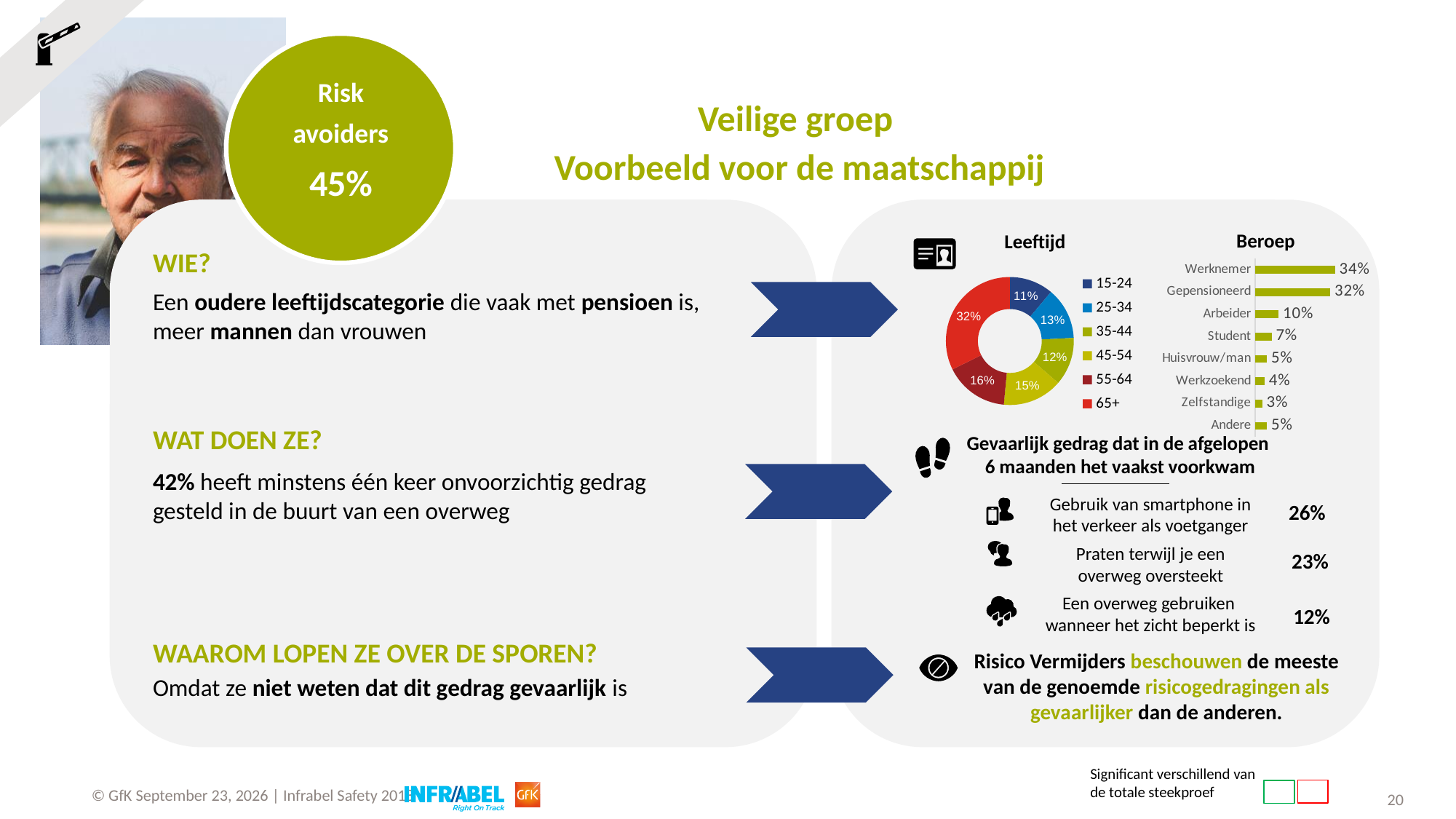
In the Beroep chart, what is the difference between Werknemer and Arbeider? 24% In the Beroep chart, which category has the lowest value? Zelfstandige In the Leeftijd chart, which age group has the largest share? 65+ In the Leeftijd chart, how many age groups does the legend list? 6 In the Beroep chart, what is the value for Student? 7% In the Beroep chart, how many occupation categories are shown? 8 In the Beroep chart, which category has the highest value? Werknemer In the Leeftijd chart, what share is shown for the 65+ age group? 32% In the Leeftijd chart, which age group has the smallest share? 15-24 In the Beroep chart, what is the value for Gepensioneerd? 32% In the Leeftijd chart, what share is shown for the 25-34 age group? 13% What kind of chart is the Leeftijd chart? Donut (pie) chart